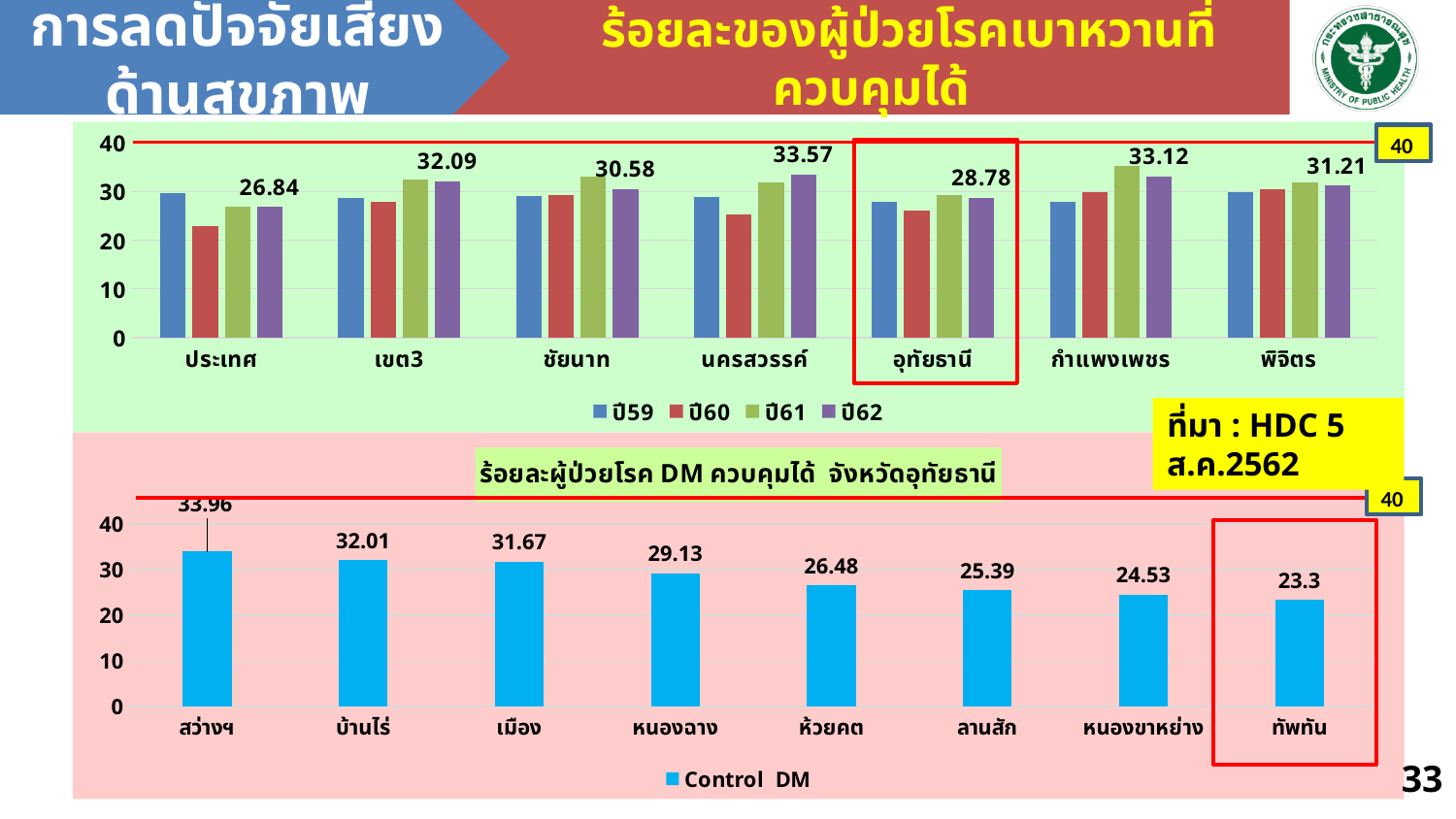
In the top chart (ร้อยละของผู้ป่วยโรคเบาหวานที่ควบคุมได้), is the labelled ปี62 value for อุทัยธานี greater or less than 30? less In the bottom chart (ร้อยละผู้ป่วยโรค DM ควบคุมได้ จังหวัดอุทัยธานี), do the values rise or fall from left to right? fall In the bottom chart (ร้อยละผู้ป่วยโรค DM ควบคุมได้ จังหวัดอุทัยธานี), what series name does the legend show? Control DM In the top chart (ร้อยละของผู้ป่วยโรคเบาหวานที่ควบคุมได้), how many series does the legend list? 4 In the bottom chart (ร้อยละผู้ป่วยโรค DM ควบคุมได้ จังหวัดอุทัยธานี), which district has the highest value? สว่างฯ In the bottom chart (ร้อยละผู้ป่วยโรค DM ควบคุมได้ จังหวัดอุทัยธานี), what is the difference between the values for บ้านไร่ and เมือง? 0.34 In the top chart (ร้อยละของผู้ป่วยโรคเบาหวานที่ควบคุมได้), how many categories are shown on the x axis? 7 In the bottom chart (ร้อยละผู้ป่วยโรค DM ควบคุมได้ จังหวัดอุทัยธานี), how many districts are shown? 8 In the bottom chart (ร้อยละผู้ป่วยโรค DM ควบคุมได้ จังหวัดอุทัยธานี), what is the value for ทัพทัน? 23.3 In the top chart (ร้อยละของผู้ป่วยโรคเบาหวานที่ควบคุมได้), what is the labelled value for ปี62 for นครสวรรค์? 33.57 What kind of chart is the top chart (ร้อยละของผู้ป่วยโรคเบาหวานที่ควบคุมได้)? bar chart In the bottom chart (ร้อยละผู้ป่วยโรค DM ควบคุมได้ จังหวัดอุทัยธานี), which district has the lowest value? ทัพทัน